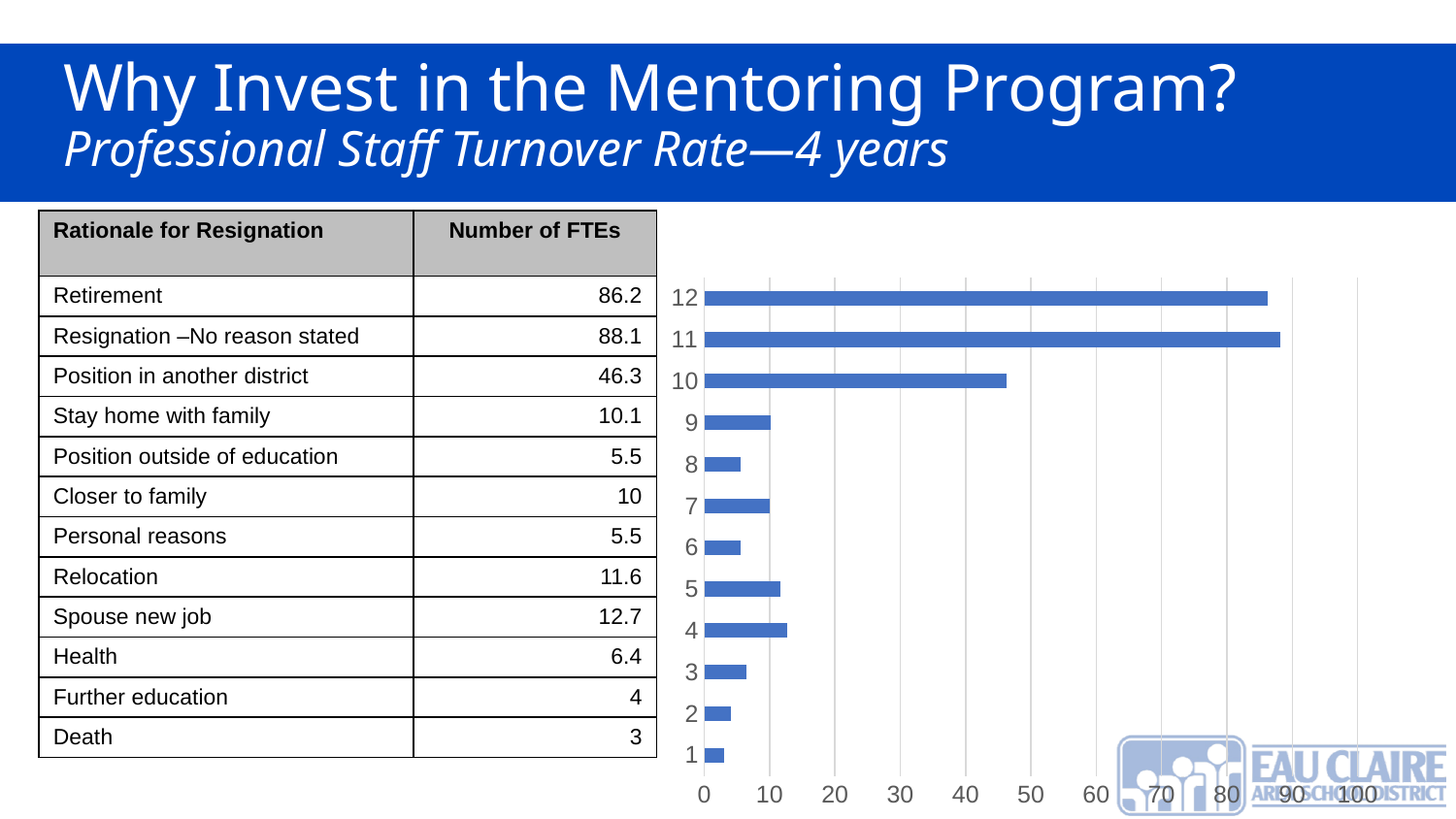
Is the value for category 10 greater or less than 40? greater Is the value for category 4 greater or less than 10? greater Which has the larger value, category 4 or category 3? 4 Is the value for category 12 greater or less than 80? greater What is the highest tick value shown on the chart's horizontal axis? 100 Which category has the longest bar in the chart? 11 Which category has the shortest bar in the chart? 1 Which has the larger value, category 10 or category 9? 10 How many categories (bars) does the chart show? 12 What kind of chart is shown on the slide? bar chart